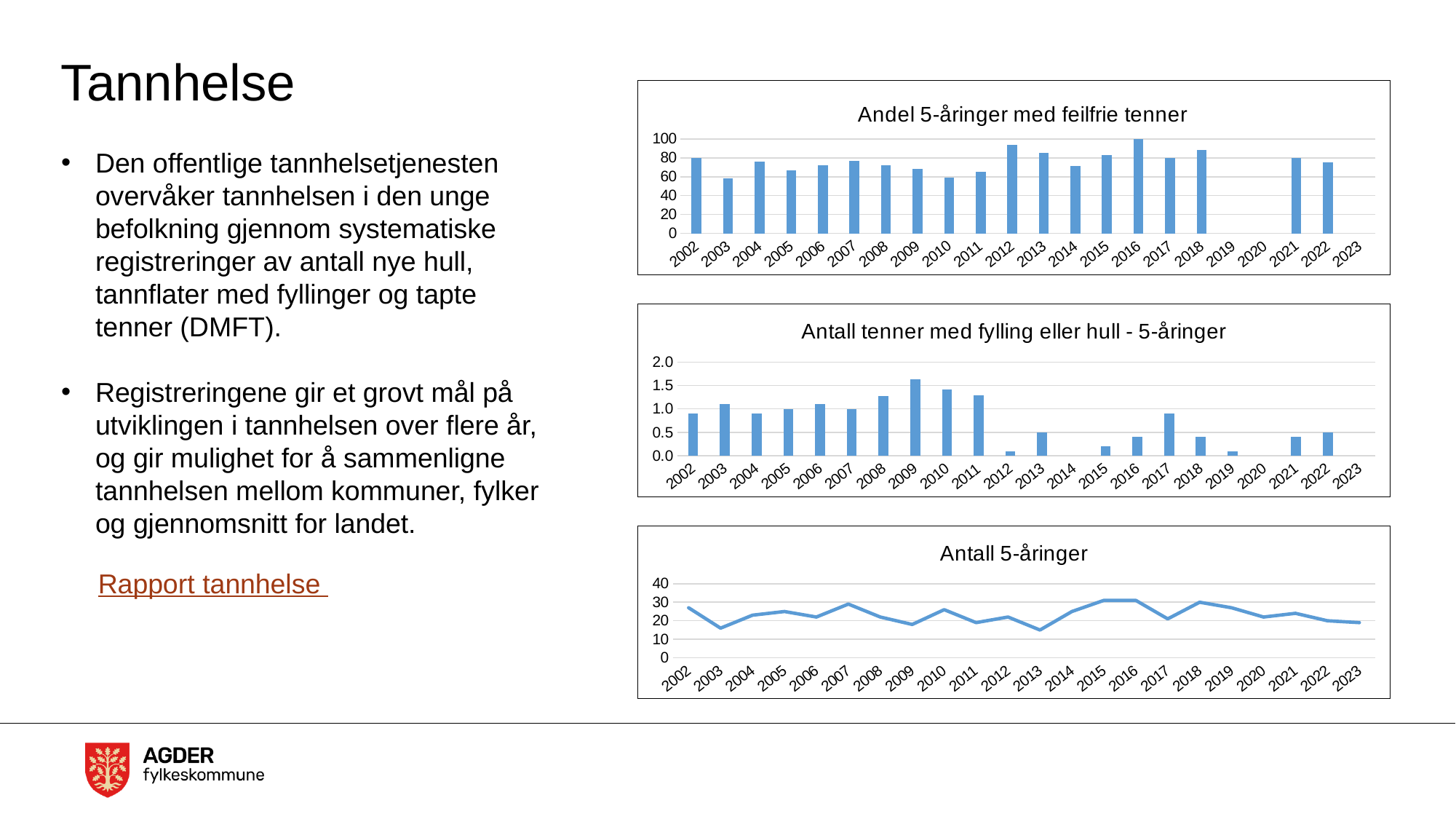
In the bottom chart 'Antall 5-åringer', is the value for 2007 greater or less than 20? greater In the top chart 'Andel 5-åringer med feilfrie tenner', is the value for 2012 greater or less than 80? greater In the middle chart 'Antall tenner med fylling eller hull - 5-åringer', is the value for 2013 greater or less than 1.0? less In the middle chart 'Antall tenner med fylling eller hull - 5-åringer', which year has the highest value? 2009 What kind of chart is the top chart, 'Andel 5-åringer med feilfrie tenner'? bar chart In the top chart 'Andel 5-åringer med feilfrie tenner', which is larger, the value for 2016 or the value for 2010? 2016 In the bottom chart 'Antall 5-åringer', do the values rise or fall from 2021 to 2023? fall How many years are labelled on the x axis of the top chart 'Andel 5-åringer med feilfrie tenner'? 22 In the top chart 'Andel 5-åringer med feilfrie tenner', which year has the highest value? 2016 What kind of chart is the bottom chart, 'Antall 5-åringer'? line chart